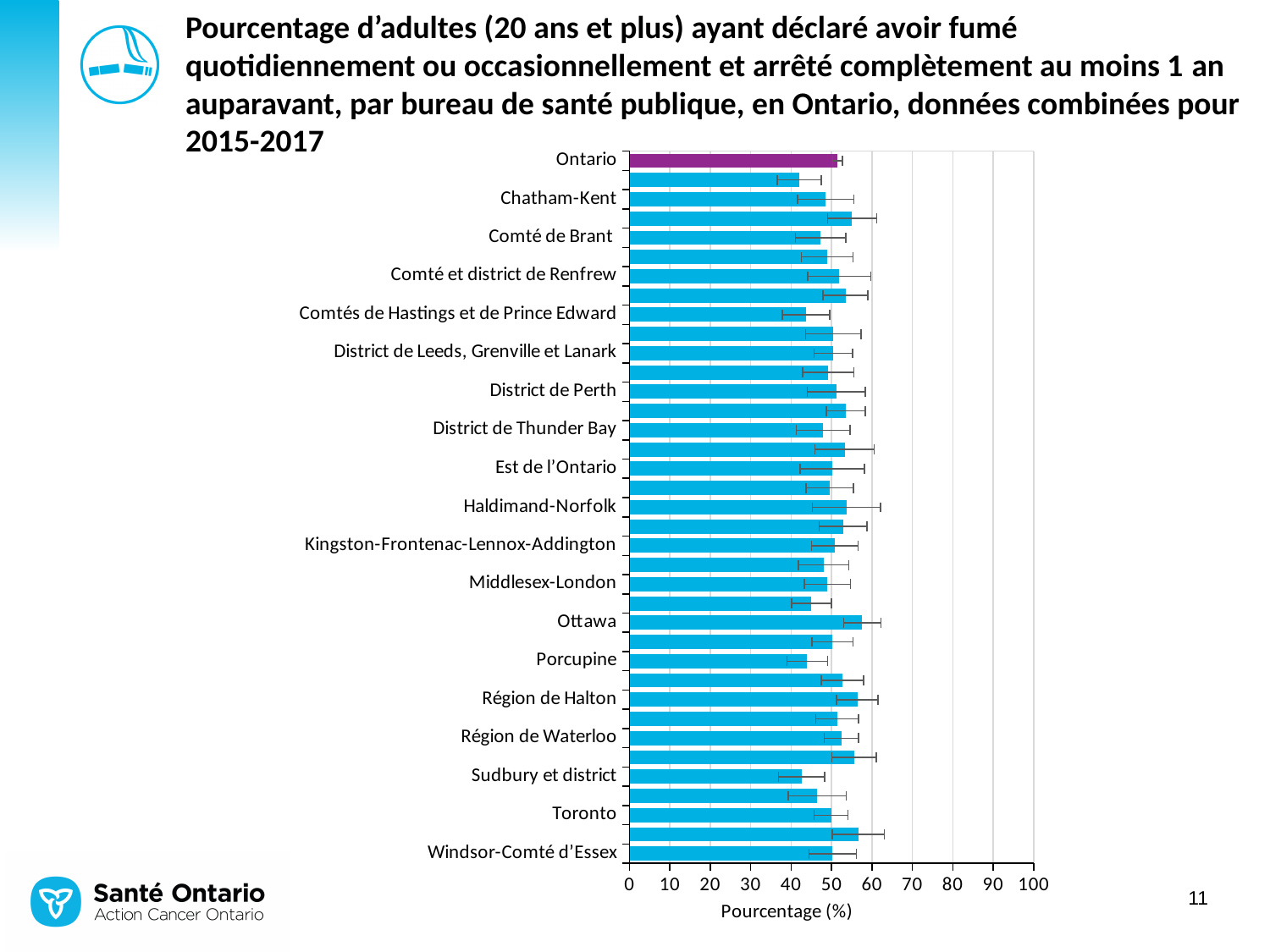
Is the value for Middlesex-London greater or less than 60? less Which has the larger value, Ottawa or Porcupine? Ottawa Is the value for Ottawa greater or less than 50? greater What kind of chart is shown on the slide? bar chart Is the value for Comtés de Hastings et de Prince Edward greater or less than 50? less What is the title of the horizontal axis? Pourcentage (%) Which has the larger value, Région de Halton or Sudbury et district? Région de Halton Which bar is drawn in a different colour (purple) from the others? Ontario